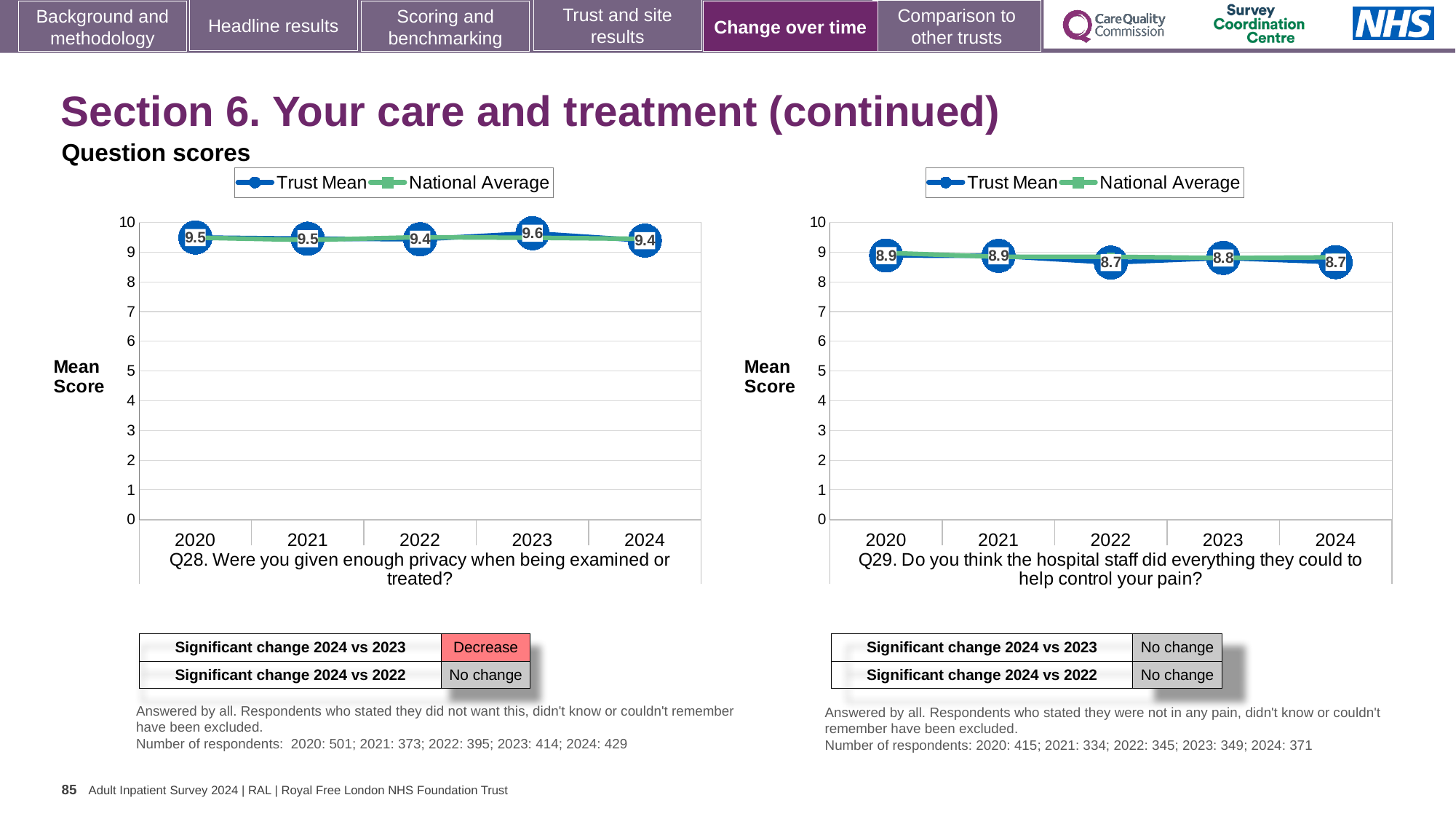
On the Q28 chart, what is the difference between the Trust Mean scores for 2023 and 2024? 0.2 What type of chart is used for Q28? line chart On the Q28 chart, which year has the highest Trust Mean score? 2023 On the Q29 chart, is the Trust Mean score for 2021 higher or lower than for 2022? higher How many series does the legend of the Q28 chart list? 2 On the Q28 chart, what is the Trust Mean score for 2023? 9.6 How many years are shown on the x axis of the Q29 chart? 5 On the Q29 chart, what is the Trust Mean score for 2022? 8.7 On the Q28 chart, what is the Trust Mean score for 2024? 9.4 On the Q29 chart, what is the difference between the Trust Mean scores for 2020 and 2024? 0.2 On the Q29 chart, what is the Trust Mean score for 2020? 8.9 On the Q28 chart, is the Trust Mean score for 2024 greater or less than 9? greater